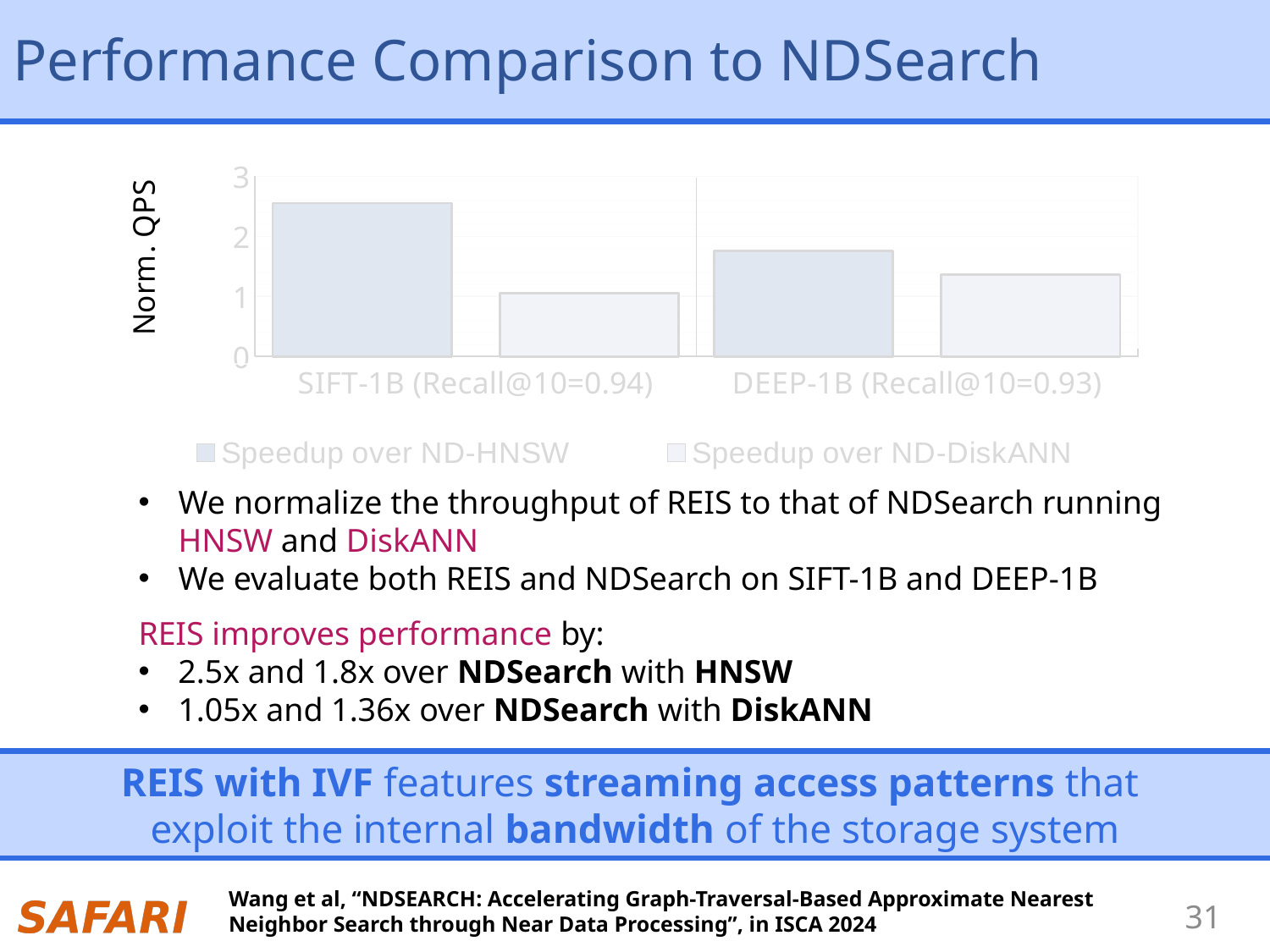
Which bar is the lowest in the chart? Speedup over ND-DiskANN for SIFT-1B (Recall@10=0.94) Which bar is the highest in the chart? Speedup over ND-HNSW for SIFT-1B (Recall@10=0.94) Is the Speedup over ND-DiskANN value for DEEP-1B (Recall@10=0.93) greater or less than 1? greater Is the Speedup over ND-HNSW value for SIFT-1B (Recall@10=0.94) greater or less than 2? greater How many series does the chart's legend list? 2 For DEEP-1B (Recall@10=0.93), which is larger: Speedup over ND-HNSW or Speedup over ND-DiskANN? Speedup over ND-HNSW What is the label of the y axis of the chart? Norm. QPS What are the two legend entries of the chart? Speedup over ND-HNSW; Speedup over ND-DiskANN How many categories are shown on the x axis of the chart? 2 Is the Speedup over ND-HNSW value for DEEP-1B (Recall@10=0.93) greater or less than 2? less Which is larger: the Speedup over ND-HNSW for SIFT-1B (Recall@10=0.94) or for DEEP-1B (Recall@10=0.93)? SIFT-1B (Recall@10=0.94) What kind of chart is shown on the slide? bar chart